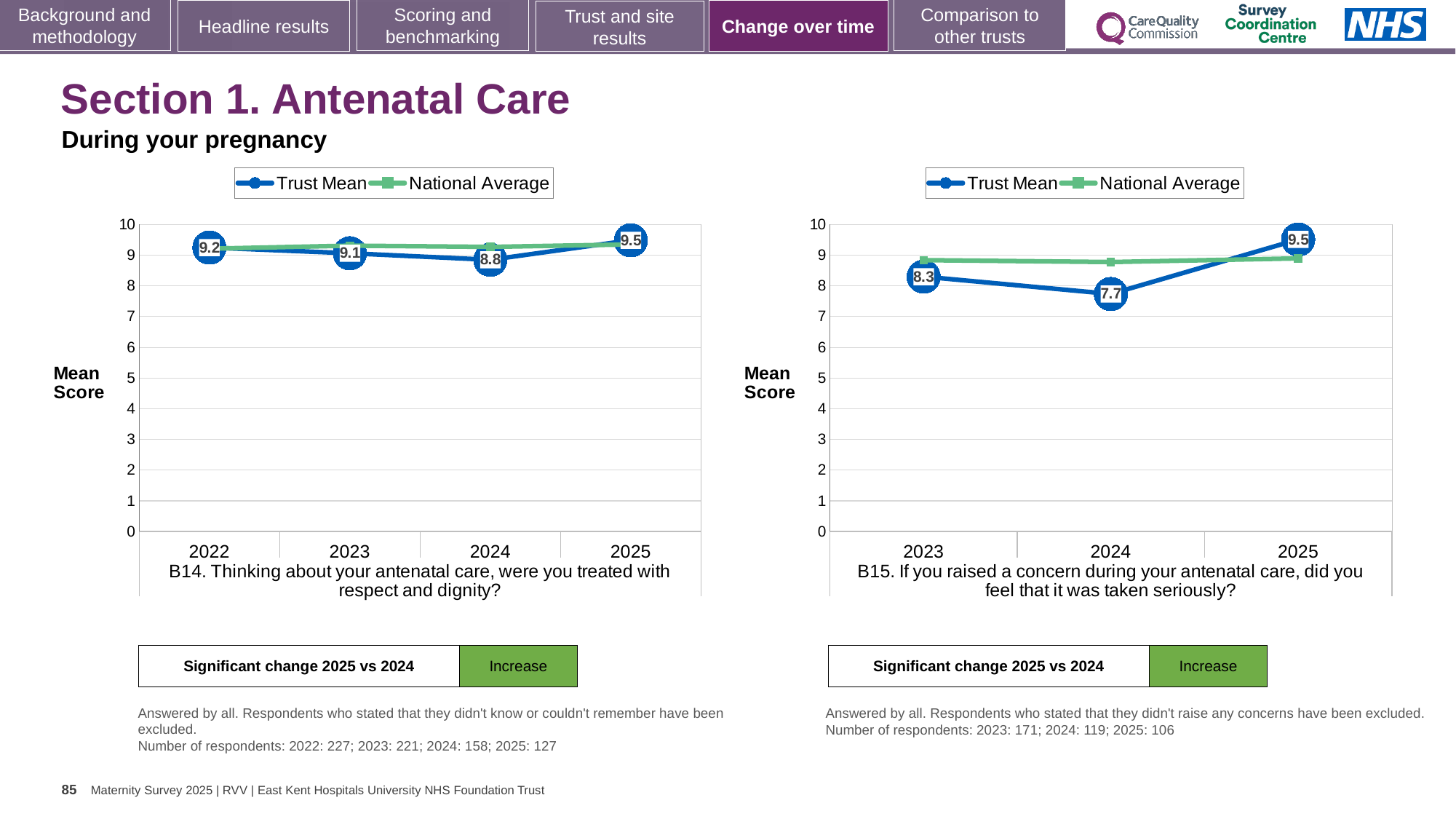
In the B15 chart (right), what is the Trust Mean score for 2023? 8.3 In the B15 chart (right), what is the Trust Mean score for 2024? 7.7 In the B15 chart (right), is the National Average value for 2024 greater or less than 8? greater In the B14 chart (left), which year has the highest Trust Mean score? 2025 In the B14 chart (left), is the Trust Mean score for 2023 larger or smaller than the Trust Mean score for 2024? larger In the B14 chart (left), what is the Trust Mean score for 2022? 9.2 In the B14 chart (left), what is the Trust Mean score for 2024? 8.8 In the B14 chart (left), what is the difference between the Trust Mean scores for 2025 and 2024? 0.7 In the B15 chart (right), what is the difference between the Trust Mean scores for 2025 and 2024? 1.8 In the B15 chart (right), which year has the lowest Trust Mean score? 2024 How many series does the legend of the B14 chart (left) list? 2 How many years are plotted on the x axis of the B15 chart (right)? 3